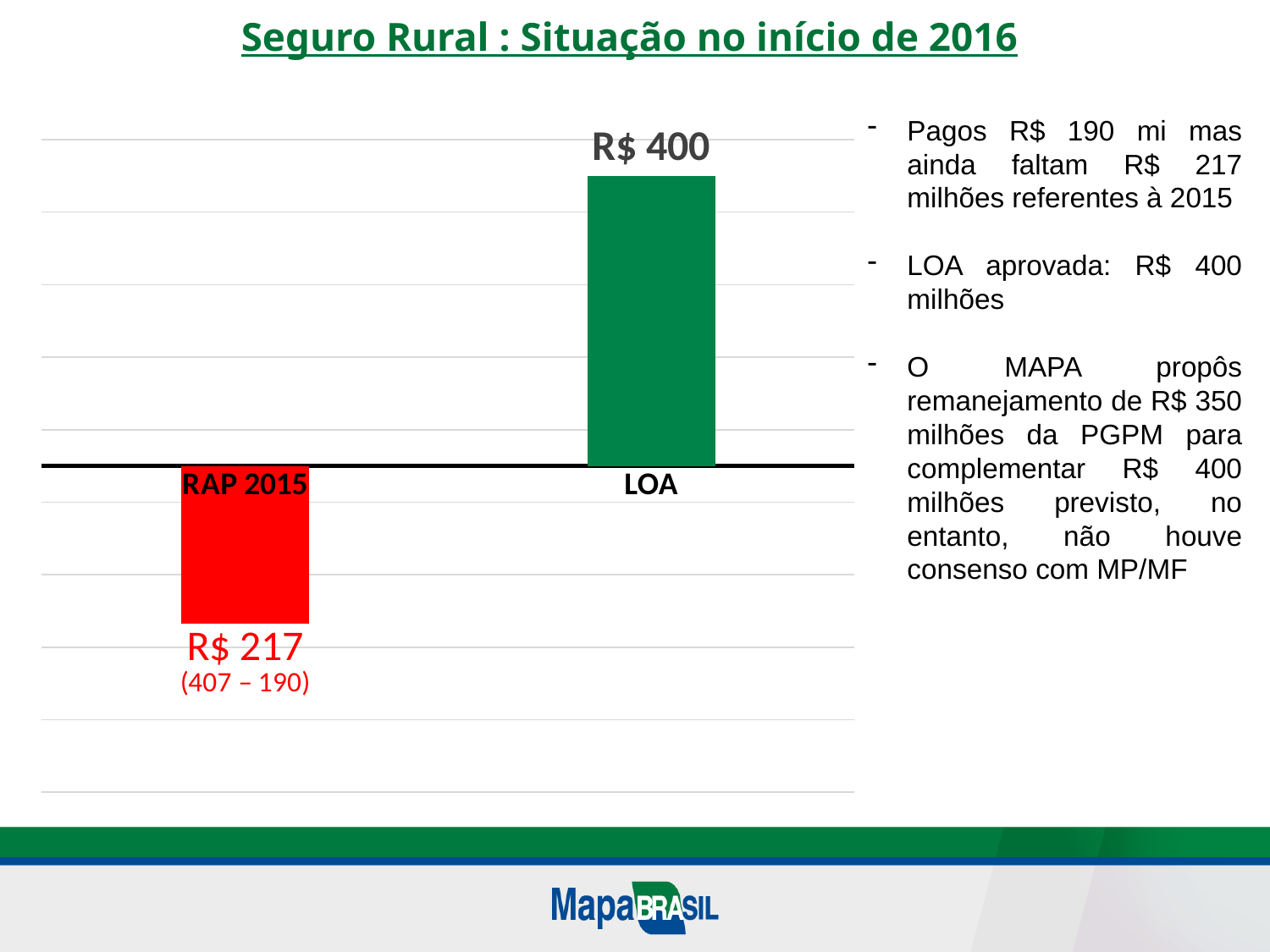
What colour is the LOA bar? Green What calculation is printed in parentheses under the RAP 2015 value? (407 – 190) What value is shown for the RAP 2015 bar? R$ 217 Which is larger, the value for LOA or the value for RAP 2015? LOA What kind of chart is shown on the slide? Bar chart Which category has the highest value in the chart? LOA How many categories (bars) are plotted in the chart? 2 Which bar extends below the horizontal axis line? RAP 2015 What is the difference between the labelled values for LOA (R$ 400) and RAP 2015 (R$ 217)? R$ 183 Which category has the lowest value in the chart? RAP 2015 What value is shown for the LOA bar? R$ 400